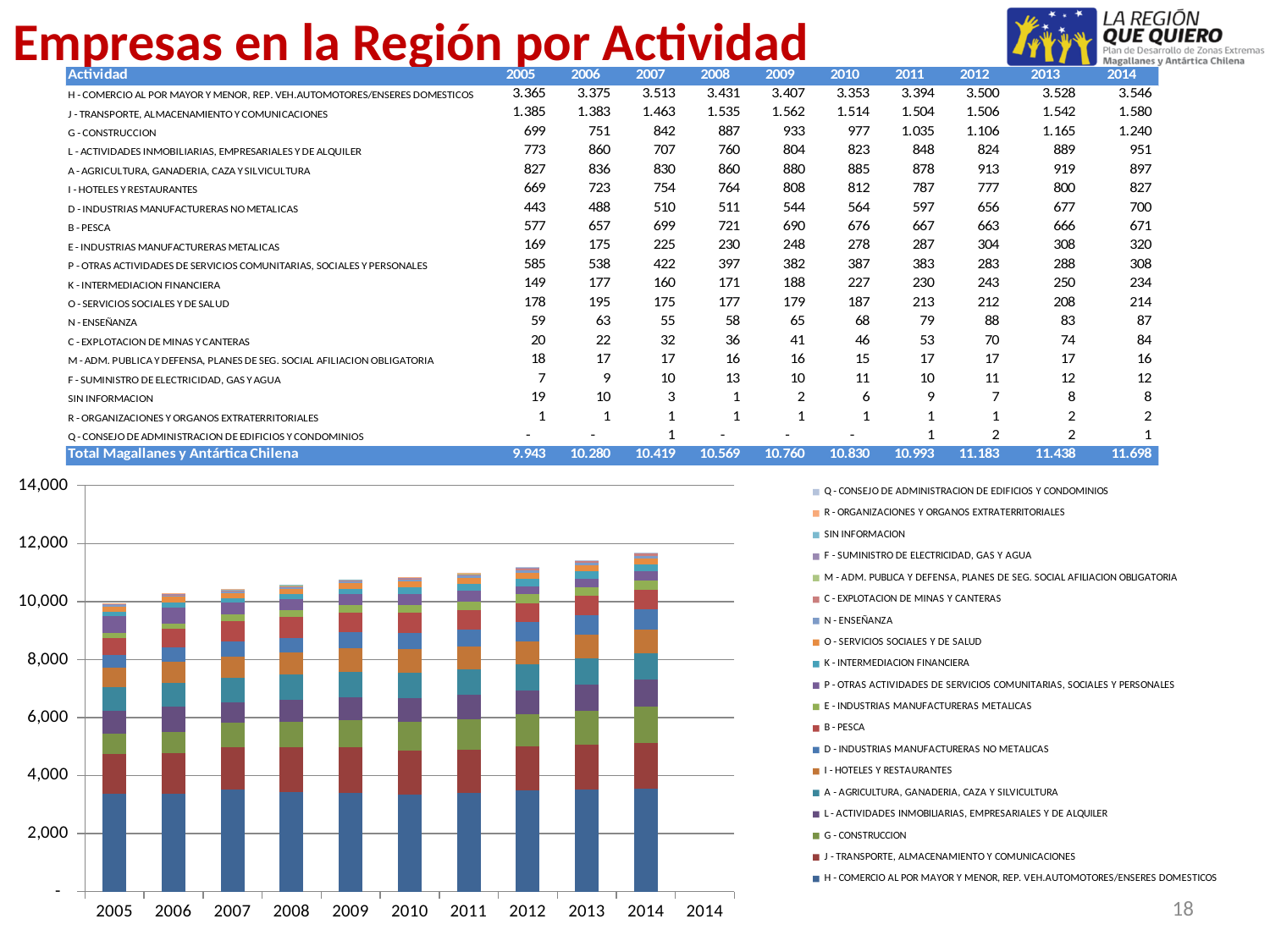
Which series forms the bottom segment of each stacked bar? H - COMERCIO AL POR MAYOR Y MENOR, REP. VEH.AUTOMOTORES/ENSERES DOMESTICOS Is the total height of the stacked bar for 2013 greater or less than 10,000? greater According to the table, what is the value for G - CONSTRUCCION in 2005? 699 How many series does the chart legend list? 19 Which year has the tallest stacked bar? 2014 Which year has the shortest stacked bar? 2005 What kind of chart is shown on the slide? Stacked bar chart Do the total heights of the stacked bars rise or fall from 2005 to 2014? rise Is the total height of the stacked bar for 2005 greater or less than 10,000? less According to the table, what is the total for Magallanes y Antártica Chilena in 2014? 11.698 Which is larger, the total for 2014 or the total for 2005? 2014 Is the total height of the stacked bar for 2014 greater or less than 12,000? less